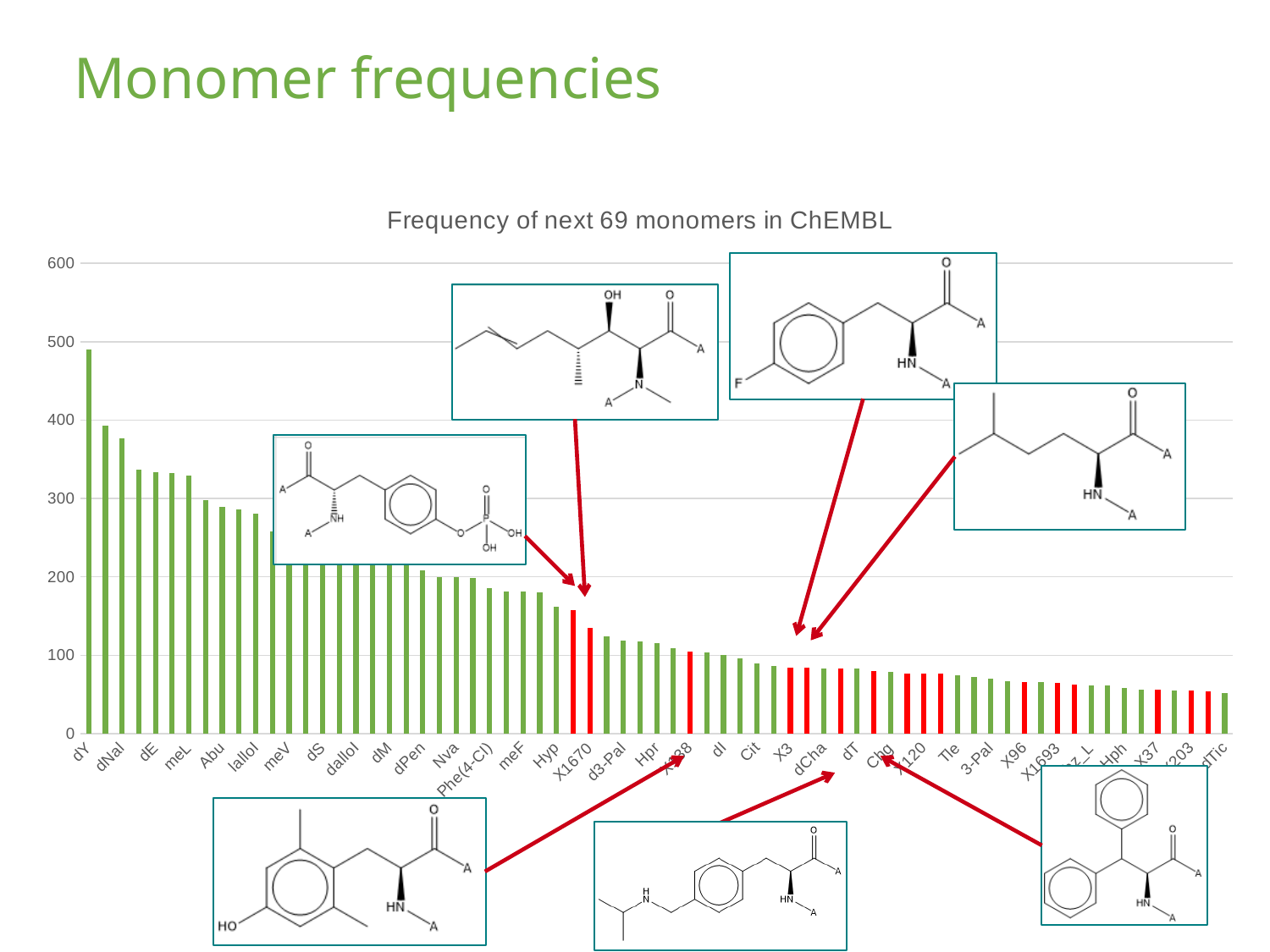
Is the value for Hyp greater or less than 200? less Is the value for meV greater or less than 300? less Which has a higher frequency, dY or dTic? dY Which labeled monomer has the lowest frequency in the chart? dTic Which monomer has the highest frequency in the chart? dY What is the title of the chart? Frequency of next 69 monomers in ChEMBL What kind of chart is shown on the slide? bar chart Do the bar values rise or fall from left to right along the x axis? fall Is the value for X1670 greater or less than 100? greater